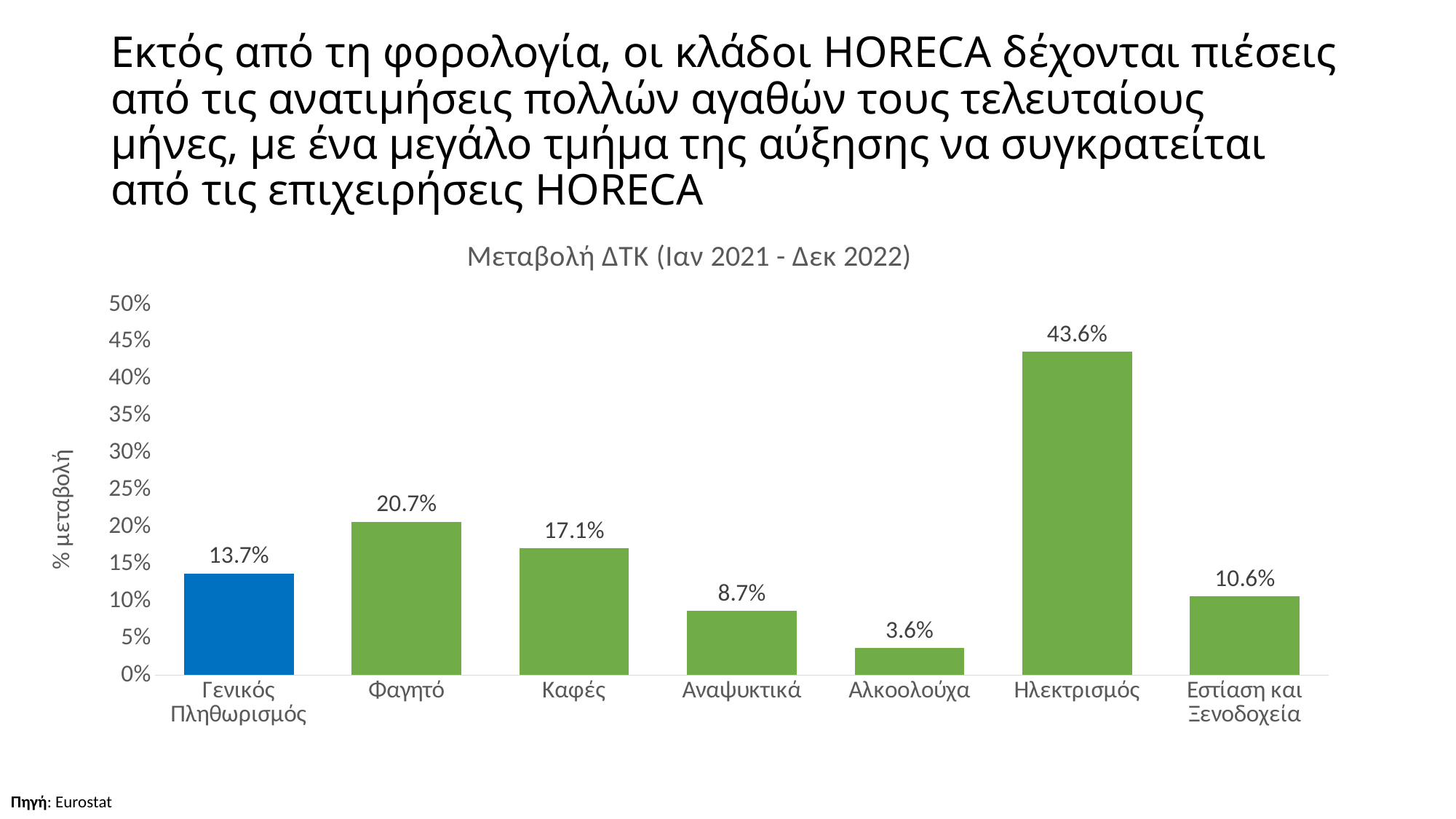
What is the title of the chart? Μεταβολή ΔΤΚ (Ιαν 2021 - Δεκ 2022) What is the value for Ηλεκτρισμός? 43.6% Which is larger, the value for Αναψυκτικά or the value for Εστίαση και Ξενοδοχεία? Εστίαση και Ξενοδοχεία What is the value for Εστίαση και Ξενοδοχεία? 10.6% How many categories are shown on the x axis? 7 Which bar is coloured blue rather than green? Γενικός Πληθωρισμός What is the value for Γενικός Πληθωρισμός? 13.7% Is the value for Φαγητό greater or less than 20%? greater What is the difference between the values for Φαγητό and Καφές? 3.6% What kind of chart is shown on the slide? bar chart Which category has the lowest value? Αλκοολούχα Which category has the highest value? Ηλεκτρισμός